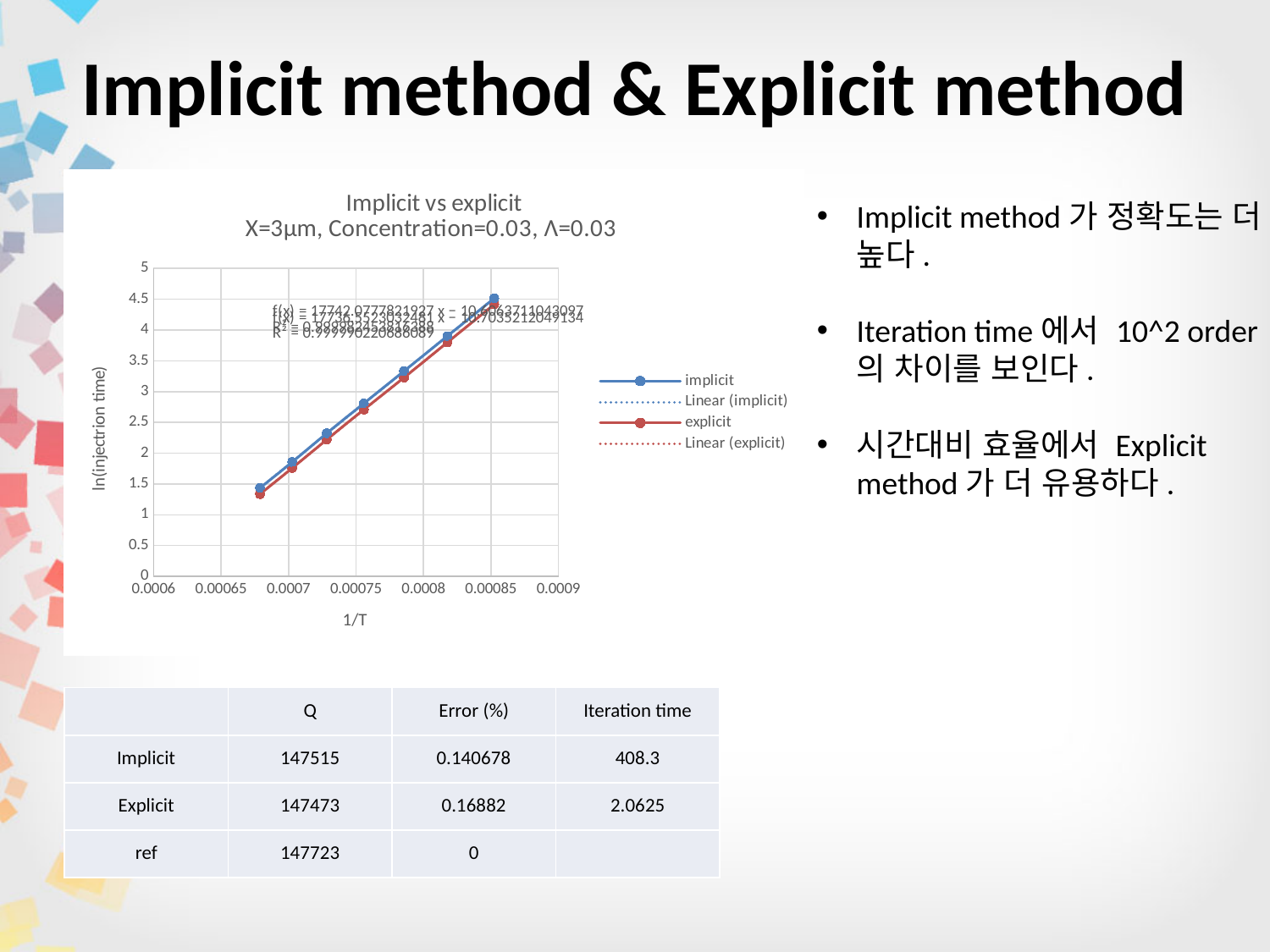
What is the label of the x axis? 1/T Is the explicit value at the smallest 1/T point greater or less than 1.5? less What is the first line of the chart title? Implicit vs explicit How many data points are plotted for the implicit series? 7 What is the highest value shown on the y axis? 5 Is the explicit value at the third point from the left (around 0.00073) greater or less than 2.5? less Do the plotted values rise or fall as 1/T increases? rise What kind of chart is shown on the slide? line chart Is the implicit value at the second-largest 1/T point (around 0.00082) greater or less than 3.5? greater How many entries does the chart legend list? 4